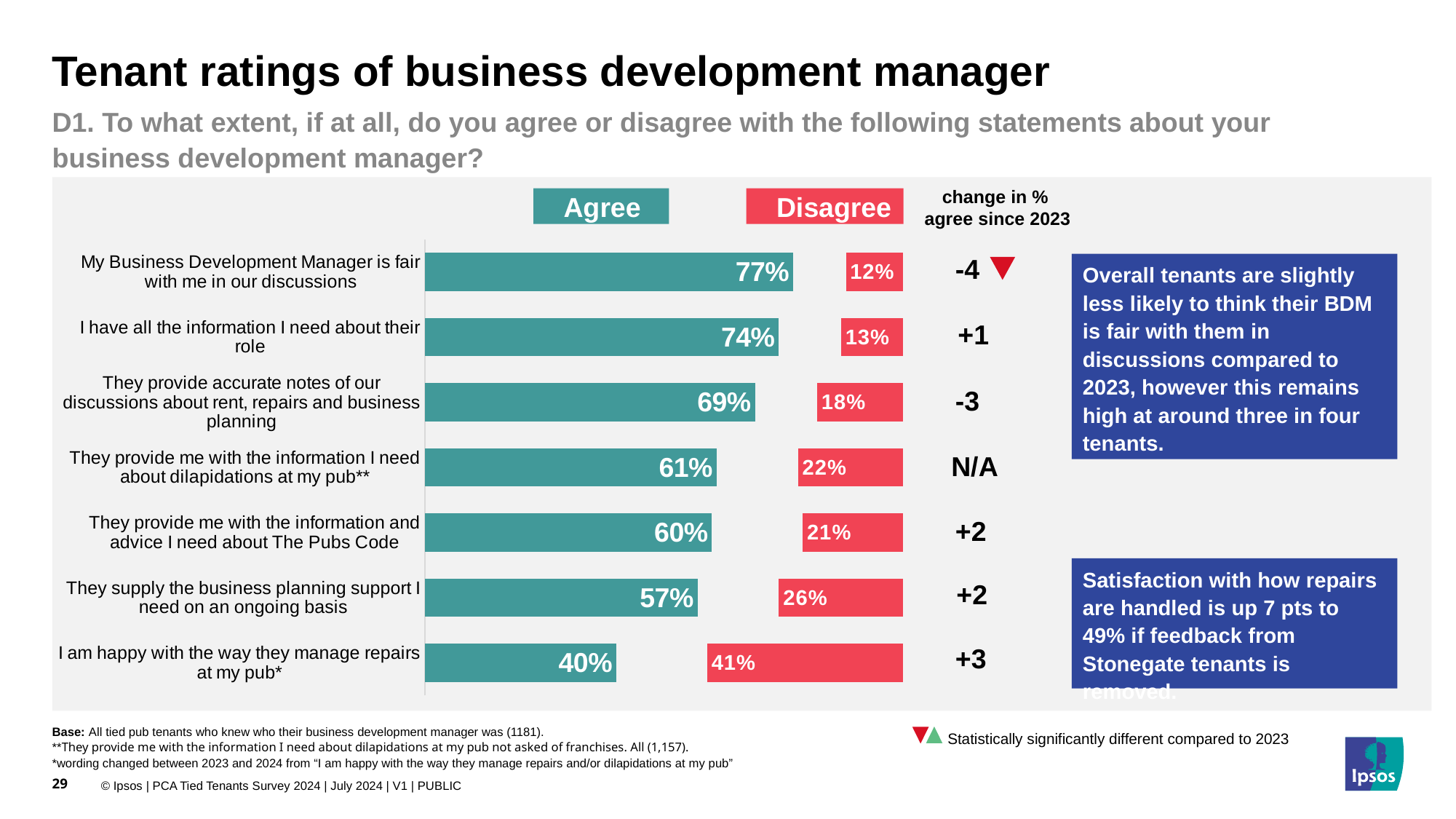
What is the change in % agree since 2023 for 'My Business Development Manager is fair with me in our discussions'? -4 How many statements are shown in the chart? 7 What percentage of tenants agree that their Business Development Manager is fair with them in their discussions? 77% What kind of chart is shown on the slide? Bar chart How many series does the chart legend list? 2 What is the difference between the Agree and Disagree percentages for 'They supply the business planning support I need on an ongoing basis'? 31 percentage points Which statement has the highest Disagree percentage? I am happy with the way they manage repairs at my pub What is the Agree value for 'They provide me with the information and advice I need about The Pubs Code'? 60% Which statement has the highest Agree percentage? My Business Development Manager is fair with me in our discussions Which statement has the lowest Agree percentage? I am happy with the way they manage repairs at my pub Which is larger: the Agree percentage for 'I have all the information I need about their role' or for 'They provide accurate notes of our discussions about rent, repairs and business planning'? I have all the information I need about their role What percentage of tenants disagree with the statement 'I am happy with the way they manage repairs at my pub'? 41%